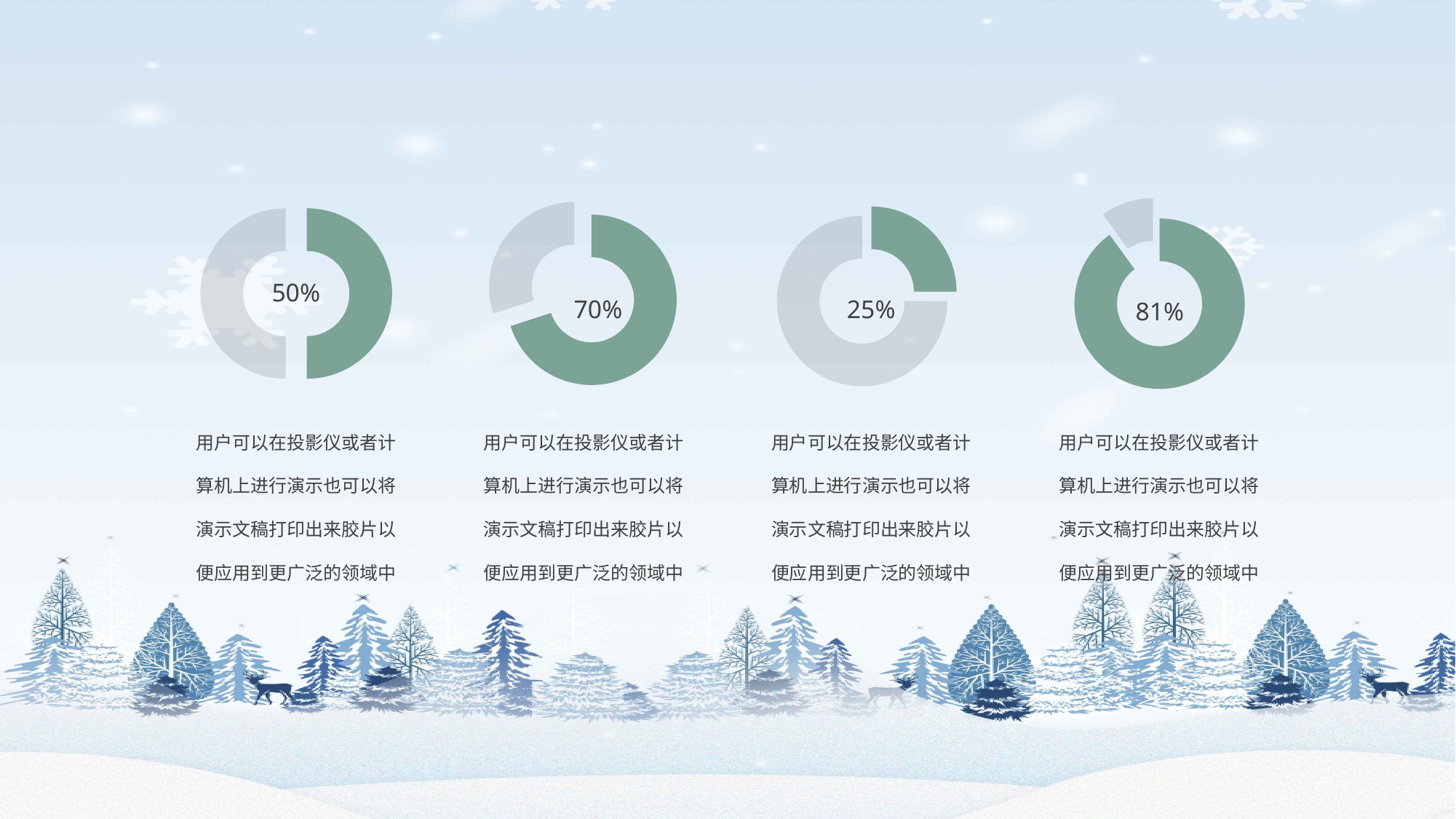
Which of the four donut charts shows the highest percentage? The rightmost chart (81%) What is the difference between the percentage in the second donut chart and the percentage in the third donut chart? 45% What kind of chart is used to display each percentage on the slide? Donut chart Which is larger, the percentage in the second donut chart from the left or the percentage in the leftmost donut chart? The second donut chart (70%) How many donut charts are on the slide? 4 What is the difference between the percentage in the rightmost donut chart and the percentage in the leftmost donut chart? 31% What percentage is shown in the centre of the third donut chart from the left? 25% What percentage is shown in the centre of the leftmost donut chart? 50% Which of the four donut charts shows the lowest percentage? The third chart from the left (25%) What colour is used for the filled (value) portion of each donut chart? Green What percentage is shown in the centre of the second donut chart from the left? 70% What percentage is shown in the centre of the rightmost donut chart? 81%